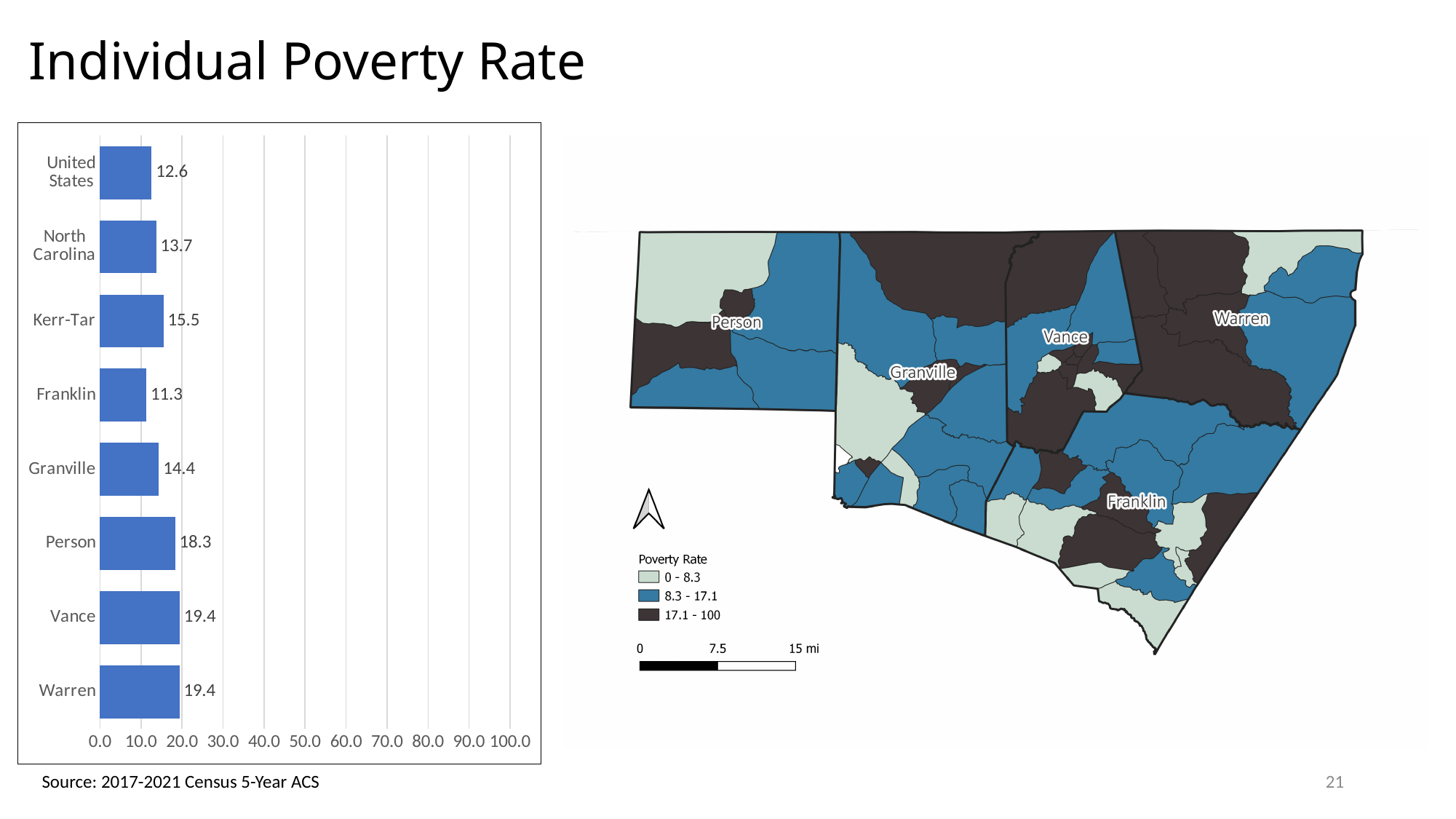
What is the individual poverty rate shown for Person? 18.3 Which has a higher value, Person or Granville? Person What is the value shown for Kerr-Tar? 15.5 What kind of chart is shown on the left of the slide? bar chart What value is shown for the United States in the bar chart? 12.6 Which category has the lowest value in the bar chart? Franklin How many categories are shown in the bar chart? 8 Is the value for Warren greater or less than 10.0? greater What is the title of the slide? Individual Poverty Rate Which has a higher value, North Carolina or Kerr-Tar? Kerr-Tar What is the difference between the values for Person and Franklin? 7.0 What is the difference between the values for Vance and the United States? 6.8